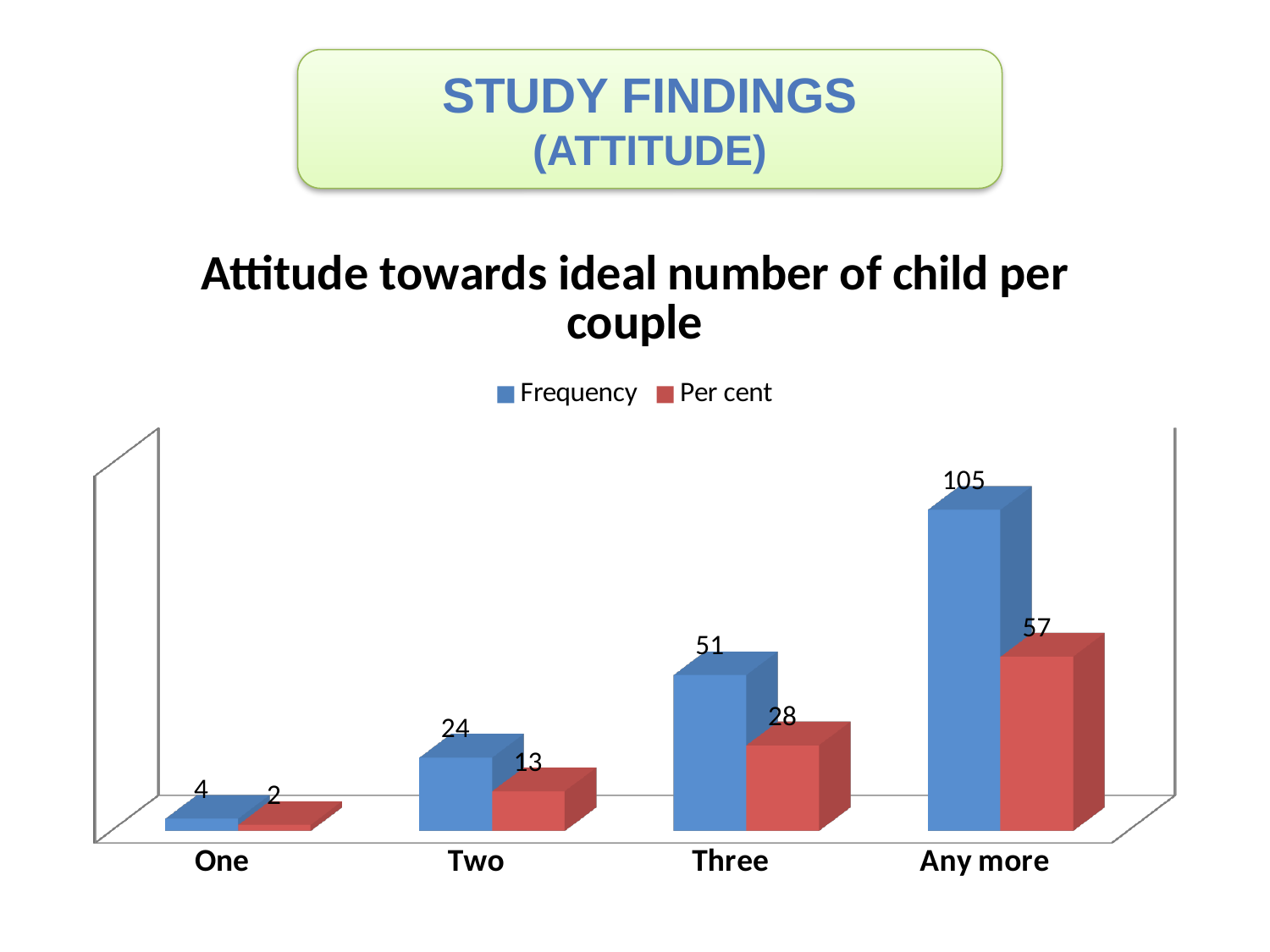
How many series does the legend list? 2 Which category has the lowest Per cent value? One Which is larger: the Frequency for 'Two' or the Per cent for 'Three'? Per cent for Three What is the Frequency value for the 'Any more' category? 105 What kind of chart is shown on the slide? Bar chart How many categories are shown on the x axis? 4 What is the Per cent value for the 'Two' category? 13 Do the Frequency values rise or fall from 'One' to 'Any more'? Rise What is the Frequency value for the 'One' category? 4 What is the Per cent value for the 'Three' category? 28 What is the difference between the Frequency values for 'Any more' and 'Three'? 54 Which category has the highest Frequency? Any more